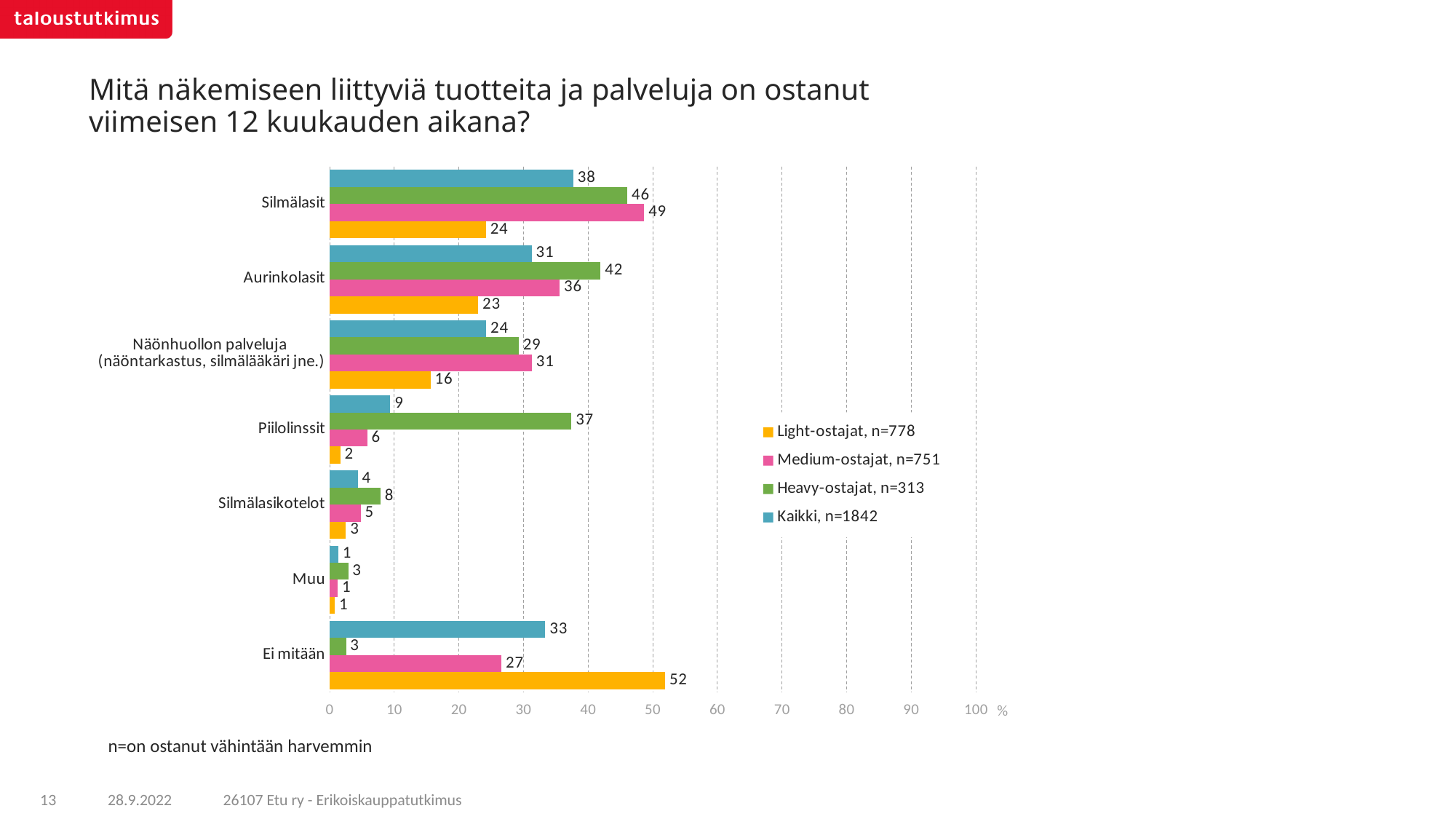
What is the sample size (n) given in the legend for Kaikki? 1842 What is the value for Light-ostajat for Ei mitään? 52 For Aurinkolasit, which is larger: the Heavy-ostajat value or the Medium-ostajat value? Heavy-ostajat What kind of chart is shown on the slide? Bar chart Which category has the highest value for Heavy-ostajat? Silmälasit What is the difference between the Medium-ostajat and Light-ostajat values for Silmälasit? 25 What is the value for Heavy-ostajat for Piilolinssit? 37 Which category has the lowest value for Kaikki? Muu What is the value for Medium-ostajat for Silmälasit? 49 What is the value for Kaikki for Aurinkolasit? 31 How many categories are shown on the chart? 7 How many series does the legend list? 4